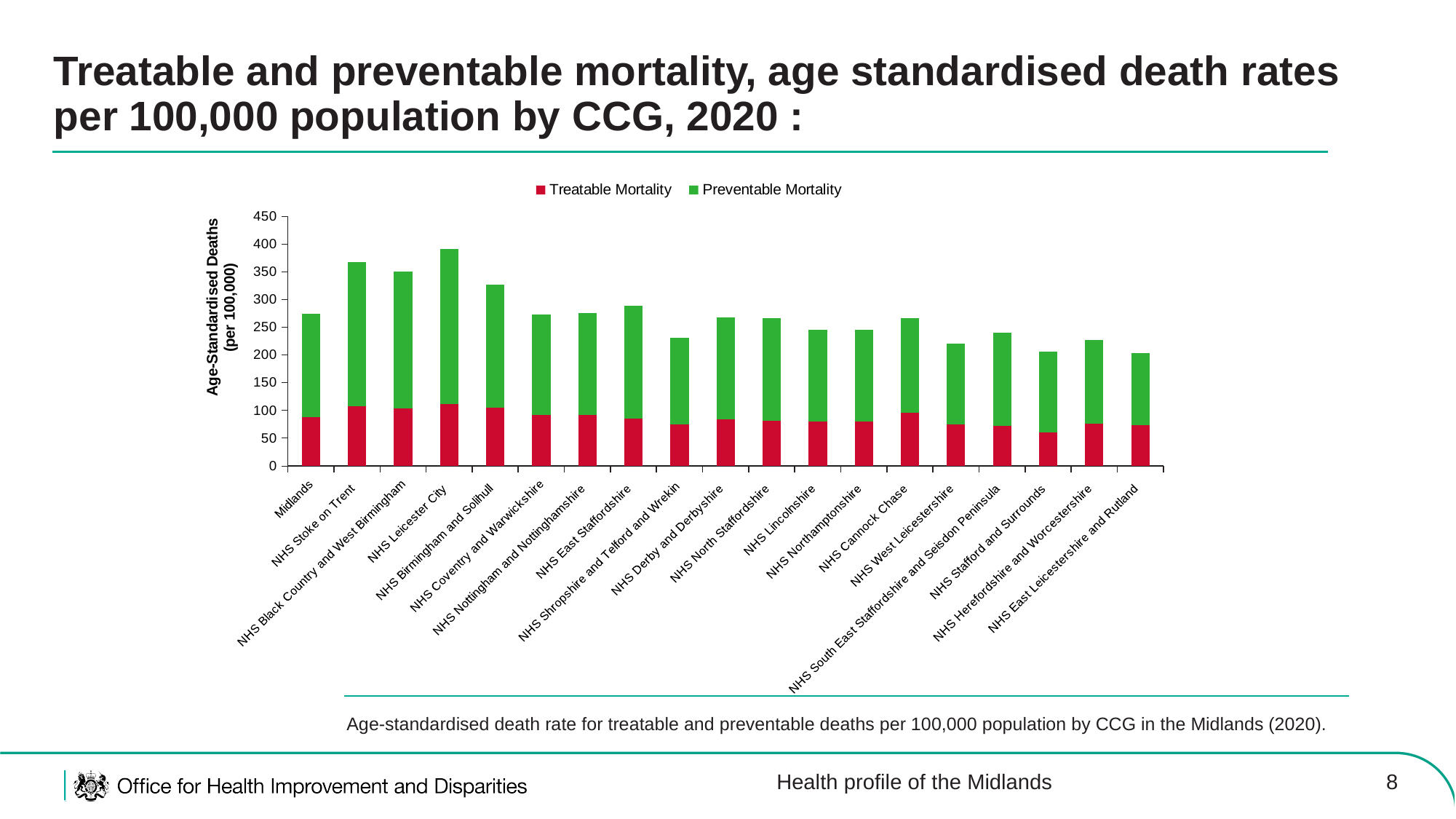
Which has the larger total value, NHS Leicester City or NHS Birmingham and Solihull? NHS Leicester City Which category has the lowest Treatable Mortality value? NHS Stafford and Surrounds Is the total value for NHS Shropshire and Telford and Wrekin greater or less than 250? less How many series does the legend list? 2 Which colour represents Preventable Mortality in the chart? Green How many CCG/area categories are plotted along the x axis? 19 Is the total value for NHS Black Country and West Birmingham greater or less than 400? less Which has the larger total value, NHS Cannock Chase or NHS West Leicestershire? NHS Cannock Chase What kind of chart is shown on the slide? Stacked bar chart Which category has the highest total age-standardised death rate? NHS Leicester City Is the total value for NHS Leicester City greater or less than 350? greater